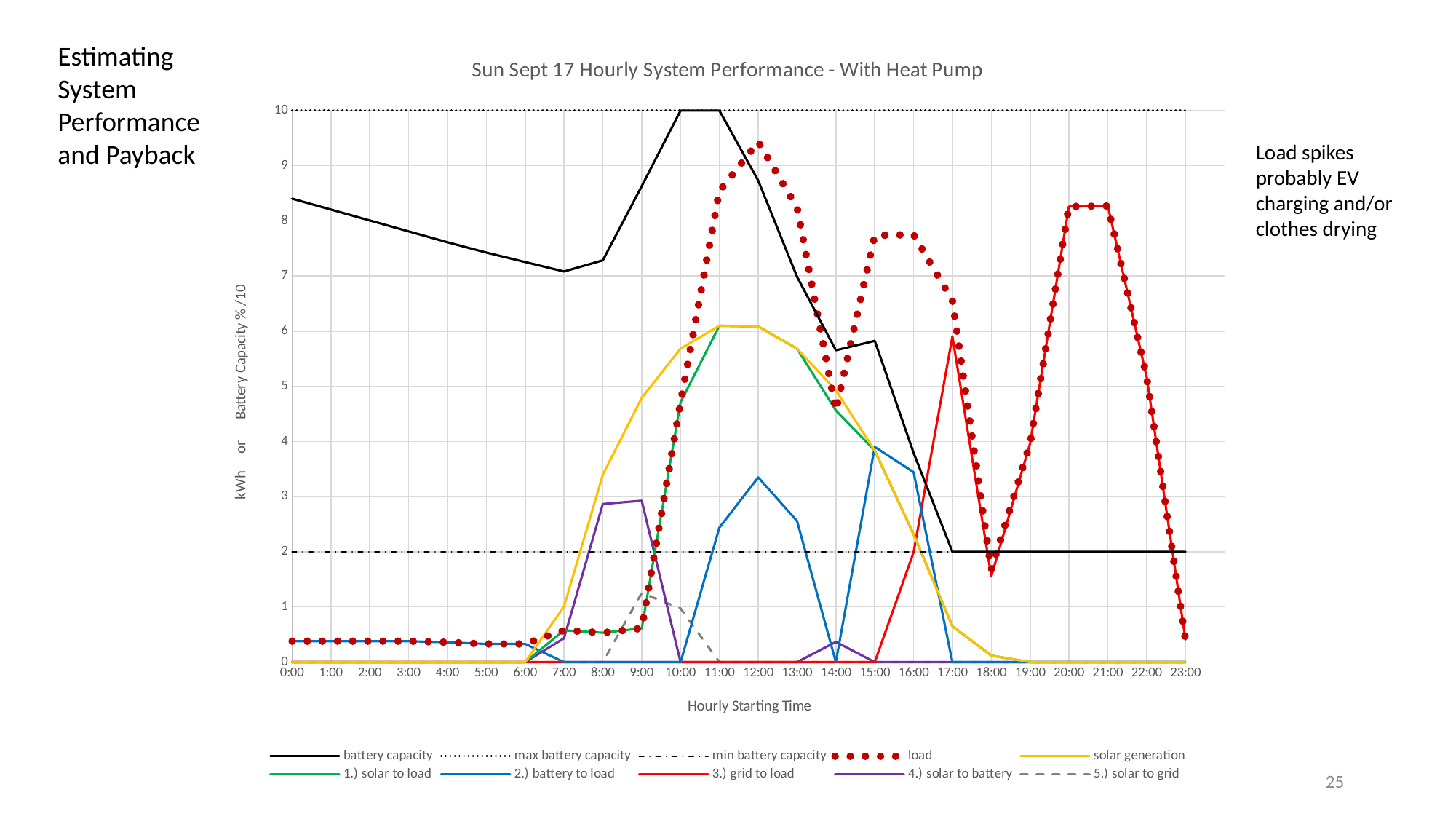
What is the battery capacity value at 20:00? 2 What is the value of the max battery capacity line? 10 What is the battery capacity value at 11:00? 10 How many hourly points are shown along the x axis? 24 Is the solar generation value at 11:00 greater or less than 5? greater What is the value of the min battery capacity line? 2 What is the solar generation value at 3:00? 0 At which hour is the load highest? 12:00 What kind of chart is shown on the slide? line chart Is the load value at 12:00 greater or less than 9? greater How many series does the legend list? 10 Does the battery capacity rise or fall from 0:00 to 7:00? fall